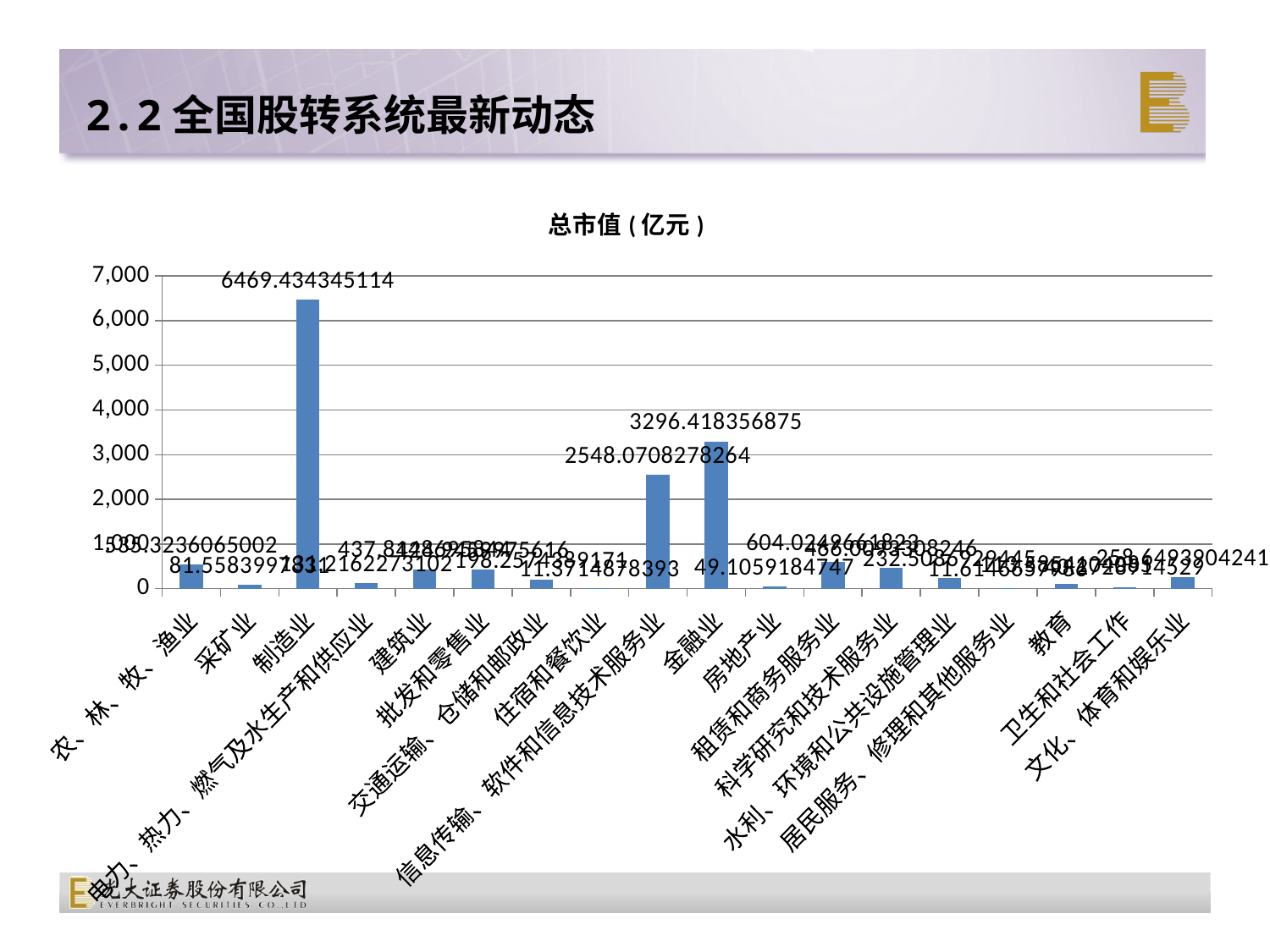
How many industry categories are shown on the x axis of the chart? 18 What is the 总市值 value shown for 金融业? 3296.418356875 What type of chart is shown on the slide? bar chart Which industry has the highest 总市值 in the chart? 制造业 Is the value for 建筑业 greater or less than 1,000? less What is the 总市值 value shown for 房地产业? 49.1059184747 What is the 总市值 value shown for 信息传输、软件和信息技术服务业? 2548.0708278264 What is the difference between the 总市值 of 金融业 and 信息传输、软件和信息技术服务业? 748.3475290486 What is the 总市值 value shown for 制造业? 6469.434345114 Is the value for 制造业 greater or less than 6,000? greater Which has a larger 总市值, 金融业 or 信息传输、软件和信息技术服务业? 金融业 What is the title of the chart? 总市值（亿元）